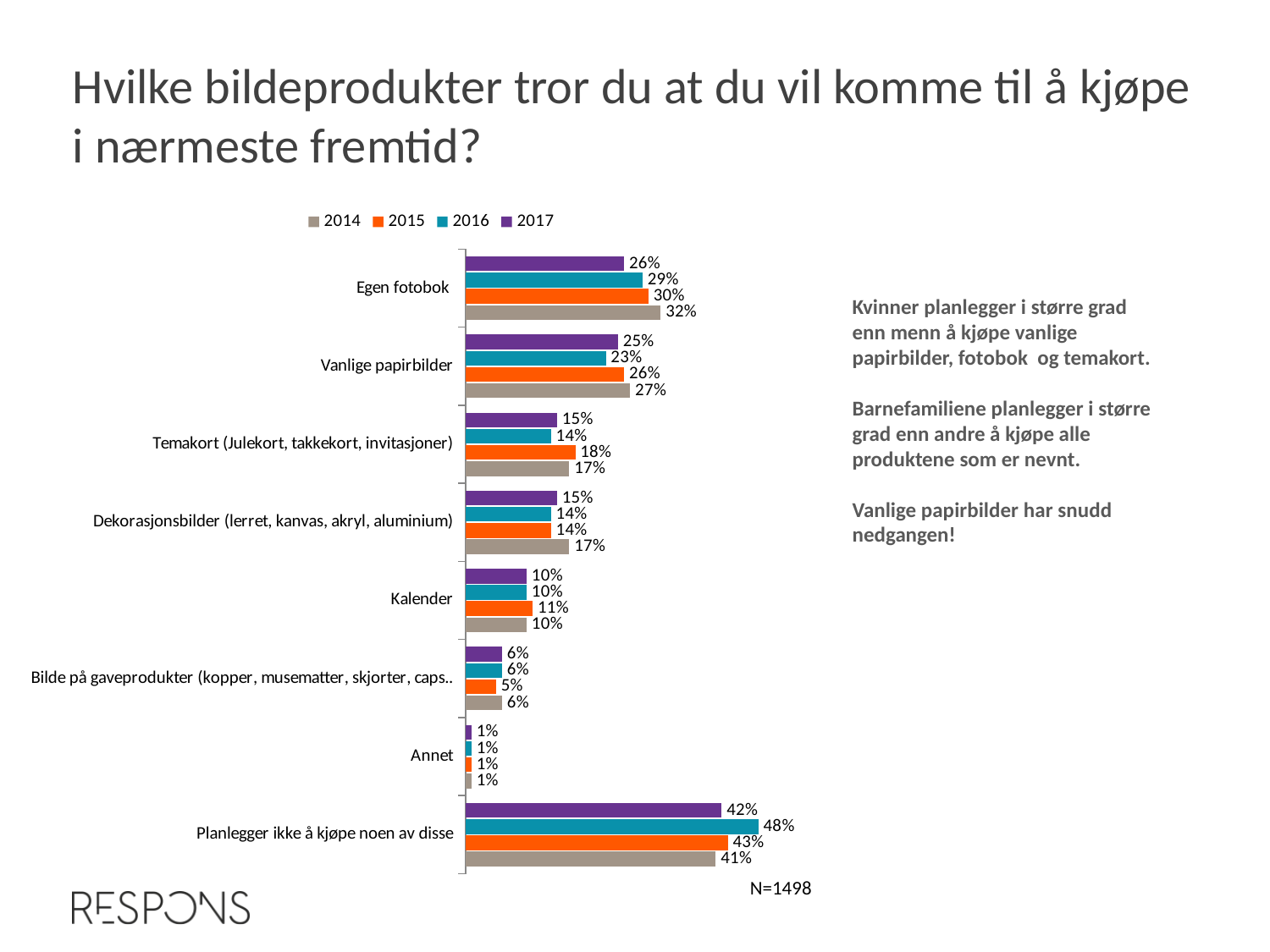
Which is larger for Vanlige papirbilder: the 2016 value or the 2017 value? 2017 Do the values for Egen fotobok rise or fall from 2014 to 2017? fall What is the value for Egen fotobok in 2017? 26% What sample size (N) is shown below the chart? N=1498 Which category has the lowest value in 2017? Annet How many categories are shown on the chart? 8 What is the value for Planlegger ikke å kjøpe noen av disse in 2016? 48% What kind of chart is shown on the slide? bar chart What is the value for Temakort (Julekort, takkekort, invitasjoner) in 2015? 18% How many series does the legend list? 4 Which category has the highest value in 2014? Planlegger ikke å kjøpe noen av disse What is the difference between the 2014 and 2017 values for Egen fotobok? 6%